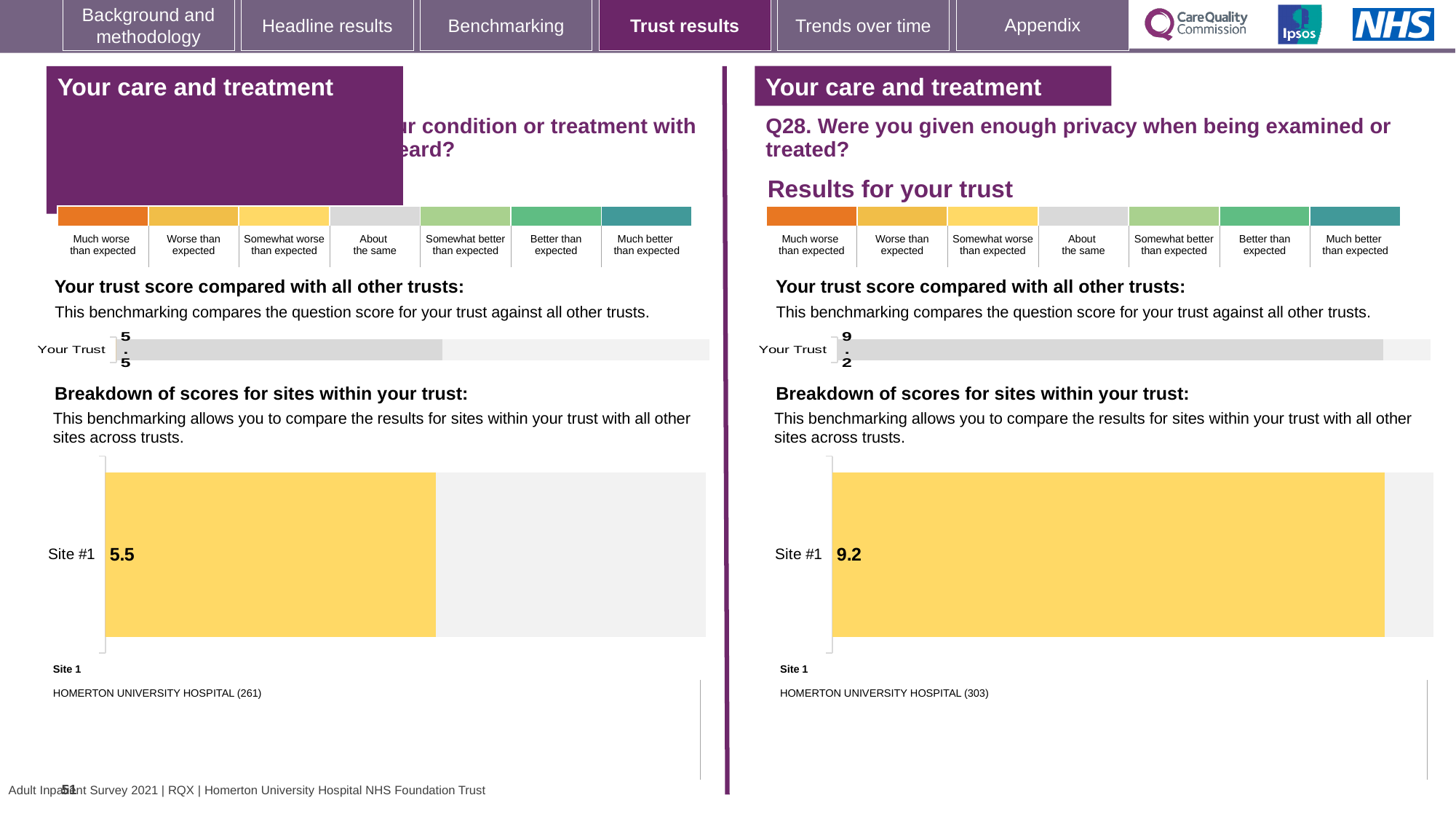
How many sites are shown in the site breakdown chart on the left-hand side? 1 What is the difference between the Site #1 score on the right-hand chart (Q28) and the Site #1 score on the left-hand chart? 3.7 On the left-hand chart, what is the score shown for Your Trust? 5.5 On the right-hand site breakdown chart for Q28, what is the score for Site #1? 9.2 On the left-hand site breakdown chart, what is the score for Site #1? 5.5 What is the difference between the Your Trust score on the right-hand chart (Q28) and the Your Trust score on the left-hand chart? 3.7 On the right-hand side for Q28, which site is listed as Site 1 below the chart? HOMERTON UNIVERSITY HOSPITAL (303) On the right-hand chart for Q28 (privacy when being examined or treated), what is the score shown for Your Trust? 9.2 How many sites are shown in the site breakdown chart on the right-hand side for Q28? 1 Which is larger: the Site #1 score on the left-hand chart or the Site #1 score on the right-hand chart for Q28? Right-hand chart (Q28) What kind of chart is used to show the Site #1 score on the right-hand side for Q28? Bar chart What colour is the Site #1 bar in the left-hand site breakdown chart? Yellow